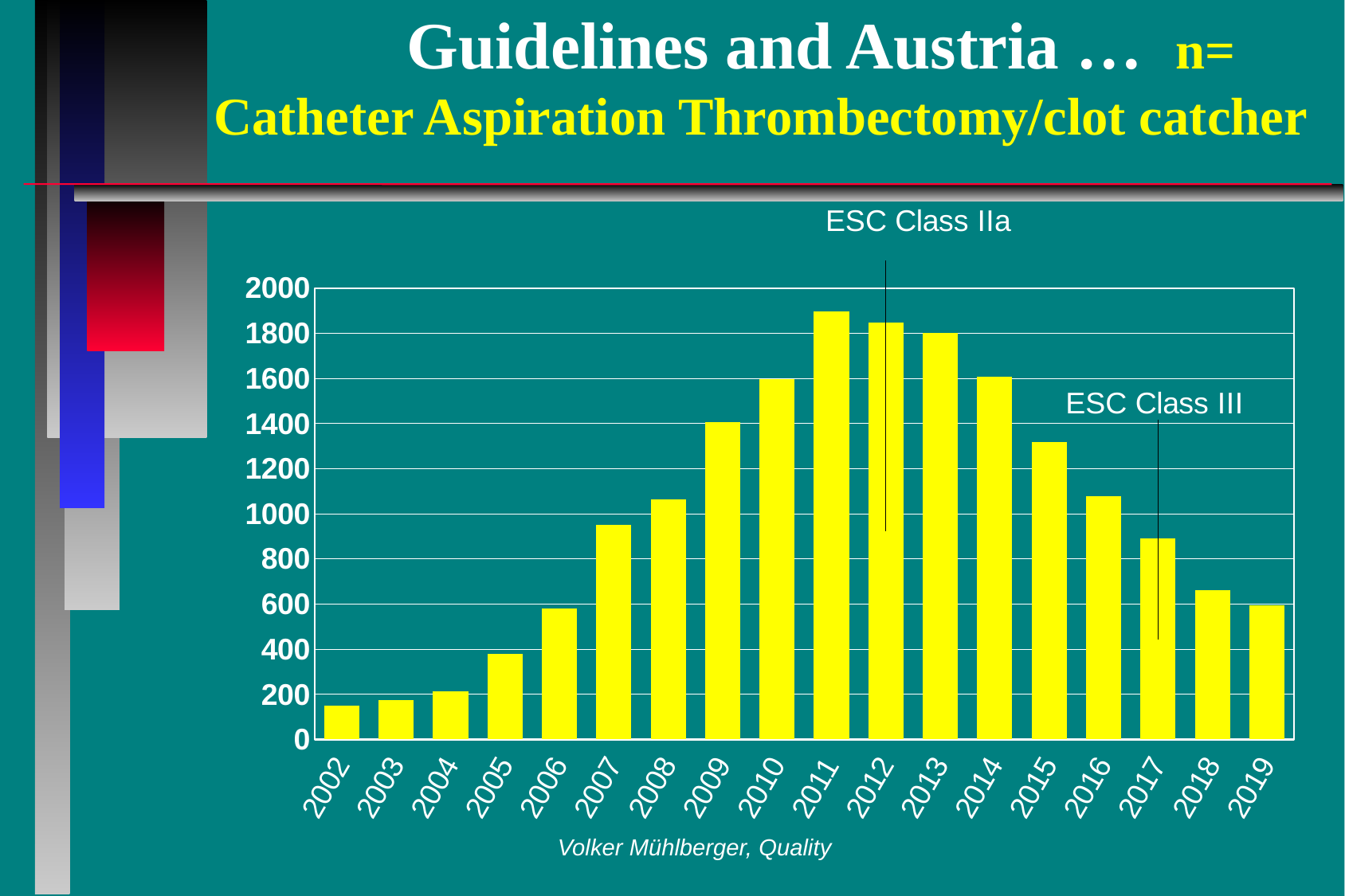
Is the value for 2019 greater or less than 400? greater How many years are shown on the x axis of the chart? 18 Do the values rise or fall from 2002 to 2011? rise Is the value for 2017 greater or less than 1000? less Is the value for 2009 greater or less than 1200? greater Do the values rise or fall from 2013 to 2019? fall What kind of chart is shown on the slide? bar chart Which year has the highest bar in the chart? 2011 Which year is marked with the annotation 'ESC Class III'? 2017 Which year has the larger value, 2010 or 2016? 2010 Which year has the larger value, 2005 or 2018? 2018